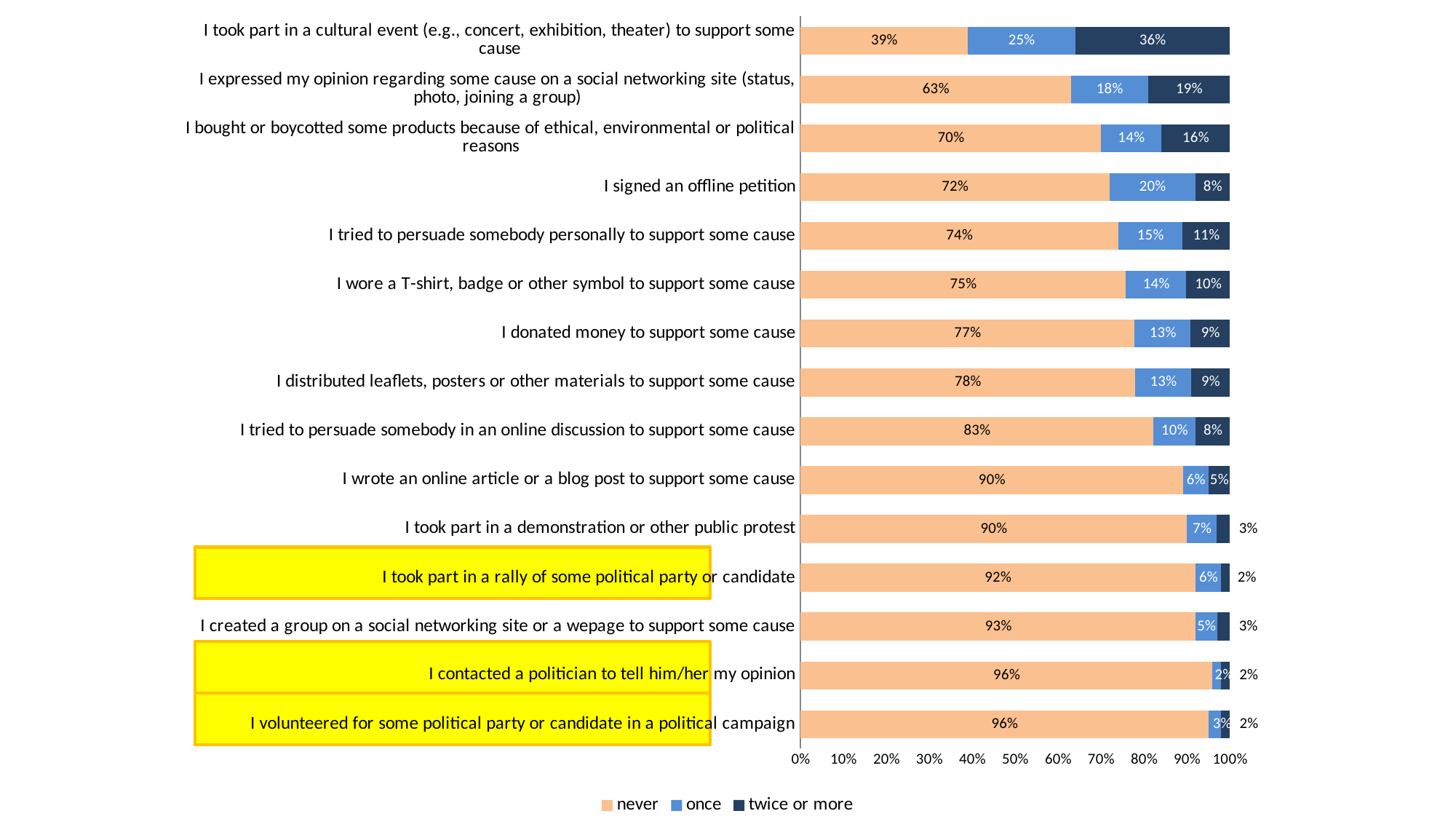
Which has a larger "twice or more" percentage: "I bought or boycotted some products because of ethical, environmental or political reasons" or "I signed an offline petition"? I bought or boycotted some products because of ethical, environmental or political reasons What percentage answered "twice or more" for "I took part in a cultural event (e.g., concert, exhibition, theater) to support some cause"? 36% Which activity has the lowest "never" percentage? I took part in a cultural event (e.g., concert, exhibition, theater) to support some cause How many activities (categories) are shown in the chart? 15 What is the difference between the "never" percentages for "I donated money to support some cause" and "I signed an offline petition"? 5% Which series is shown in the darkest colour in the legend? twice or more What kind of chart is shown on the slide? Stacked bar chart Which activity has the highest "once" percentage? I took part in a cultural event (e.g., concert, exhibition, theater) to support some cause What percentage answered "once" for "I expressed my opinion regarding some cause on a social networking site (status, photo, joining a group)"? 18% What is the total of the "once" and "twice or more" segments for "I tried to persuade somebody personally to support some cause"? 26% How many series does the legend list? 3 What percentage of respondents answered "never" for "I signed an offline petition"? 72%